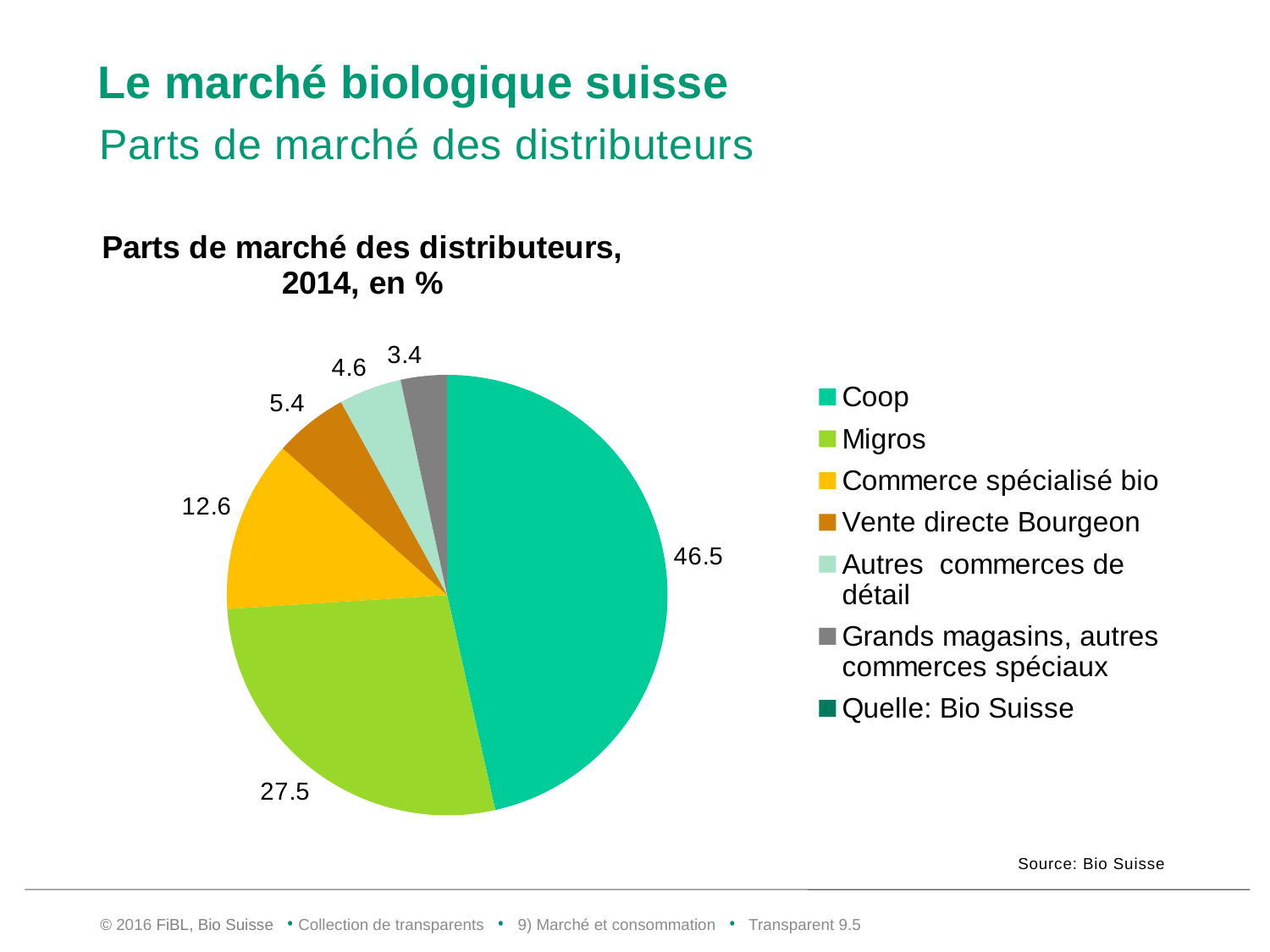
What is the value shown for Commerce spécialisé bio? 12.6 What is the market share shown for Migros? 27.5 Which is larger, the share of Vente directe Bourgeon or of Autres commerces de détail? Vente directe Bourgeon What is the value shown for Grands magasins, autres commerces spéciaux? 3.4 What is the difference between the shares of Coop and Migros? 19.0 How many slices does the pie chart have? 6 What is the title of the chart? Parts de marché des distributeurs, 2014, en % What kind of chart is shown on the slide? pie chart What is the market share shown for Coop? 46.5 What is the value shown for Vente directe Bourgeon? 5.4 Which category has the smallest slice of the pie? Grands magasins, autres commerces spéciaux Which distributor has the largest market share? Coop